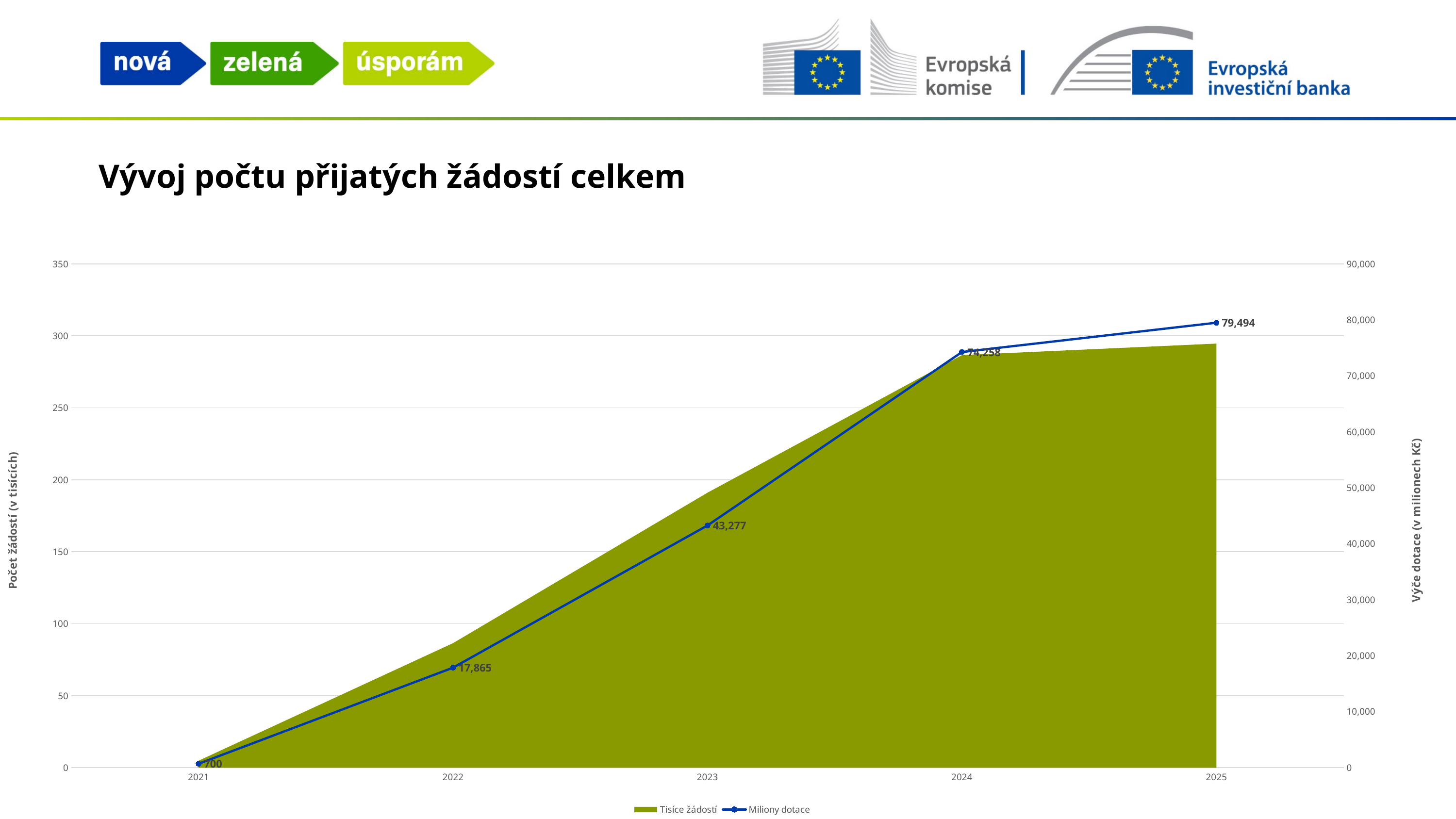
Is the value of Tisíce žádostí for 2024 greater or less than 250? greater How many series does the legend list? 2 In which year is the Miliony dotace series highest? 2025 Does the Miliony dotace series rise or fall from 2021 to 2025? rise What is the value of the Miliony dotace series for 2023? 43,277 What is the value of the Miliony dotace series for 2021? 700 In which year is the Miliony dotace series lowest? 2021 Which is larger, the Miliony dotace value for 2023 or for 2022? 2023 What is the value of the Miliony dotace series for 2022? 17,865 What is the value of the Miliony dotace series for 2025? 79,494 What is the difference between the Miliony dotace values for 2025 and 2024? 5,236 Is the value of Tisíce žádostí for 2022 greater or less than 100? less